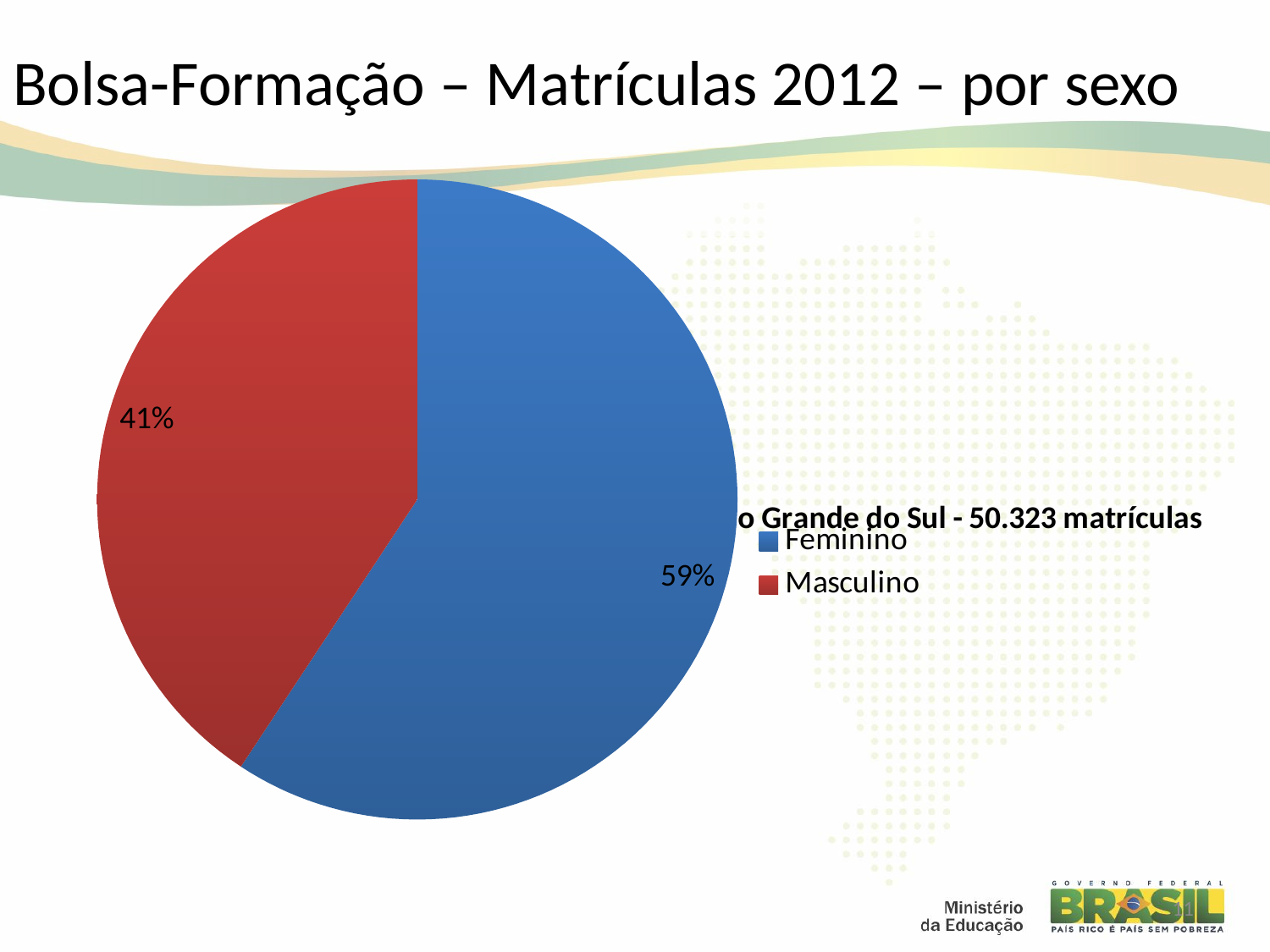
Is the share for Masculino greater or less than 50%? less Is the share for Feminino greater or less than 50%? greater Which category has the largest slice of the pie? Feminino How many entries does the legend list? 2 What is the difference in percentage points between the Feminino and Masculino slices? 18 What colour is the Masculino slice? red What share of the pie does Feminino represent? 59% Which slice is larger, Feminino or Masculino? Feminino How many slices does the pie chart have? 2 What kind of chart is shown on the slide? pie chart Which category has the smallest slice of the pie? Masculino What share of the pie does Masculino represent? 41%